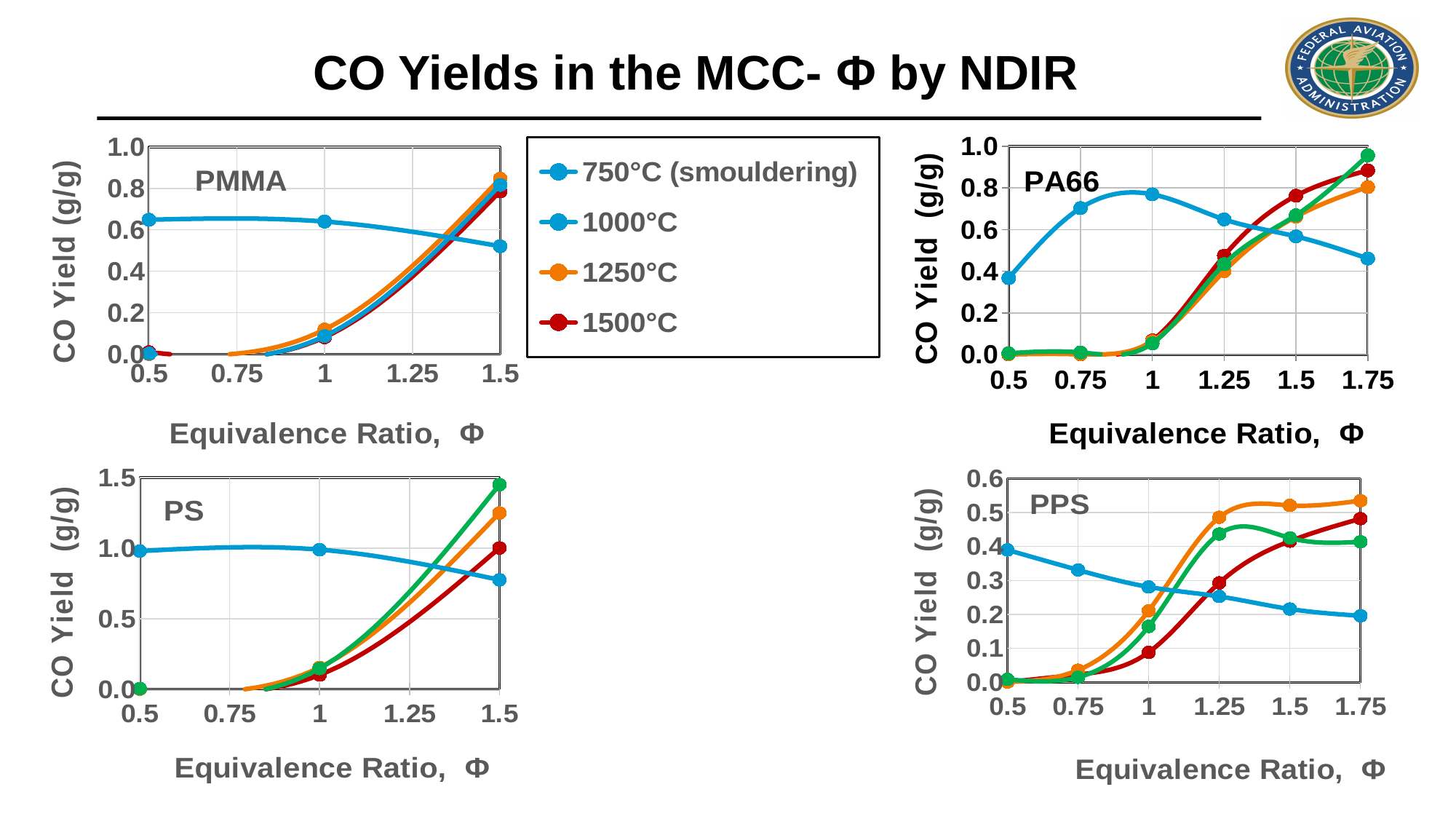
On the PPS chart, is the value for the 1250°C series at an equivalence ratio of 1.75 greater or less than 0.4? greater How many charts are shown on the slide? 4 On the PMMA chart, is the value for the 1250°C series at an equivalence ratio of 1.5 greater or less than 0.6? greater On the PMMA chart, does the 1250°C series rise or fall as the equivalence ratio increases? rise On the PA66 chart, how many equivalence ratio tick values are shown on the x axis? 6 How many series does the legend list? 4 On the PPS chart, at an equivalence ratio of 1.75, which is larger: the 1250°C series or the 1500°C series? 1250°C On the PMMA chart, is the value for the 1500°C series at an equivalence ratio of 1 greater or less than 0.2? less On the PS chart, at an equivalence ratio of 1.5, which is larger: the 1250°C series or the 1500°C series? 1250°C What is the y-axis label on the PS chart? CO Yield (g/g) What kind of chart is the PMMA chart? line chart